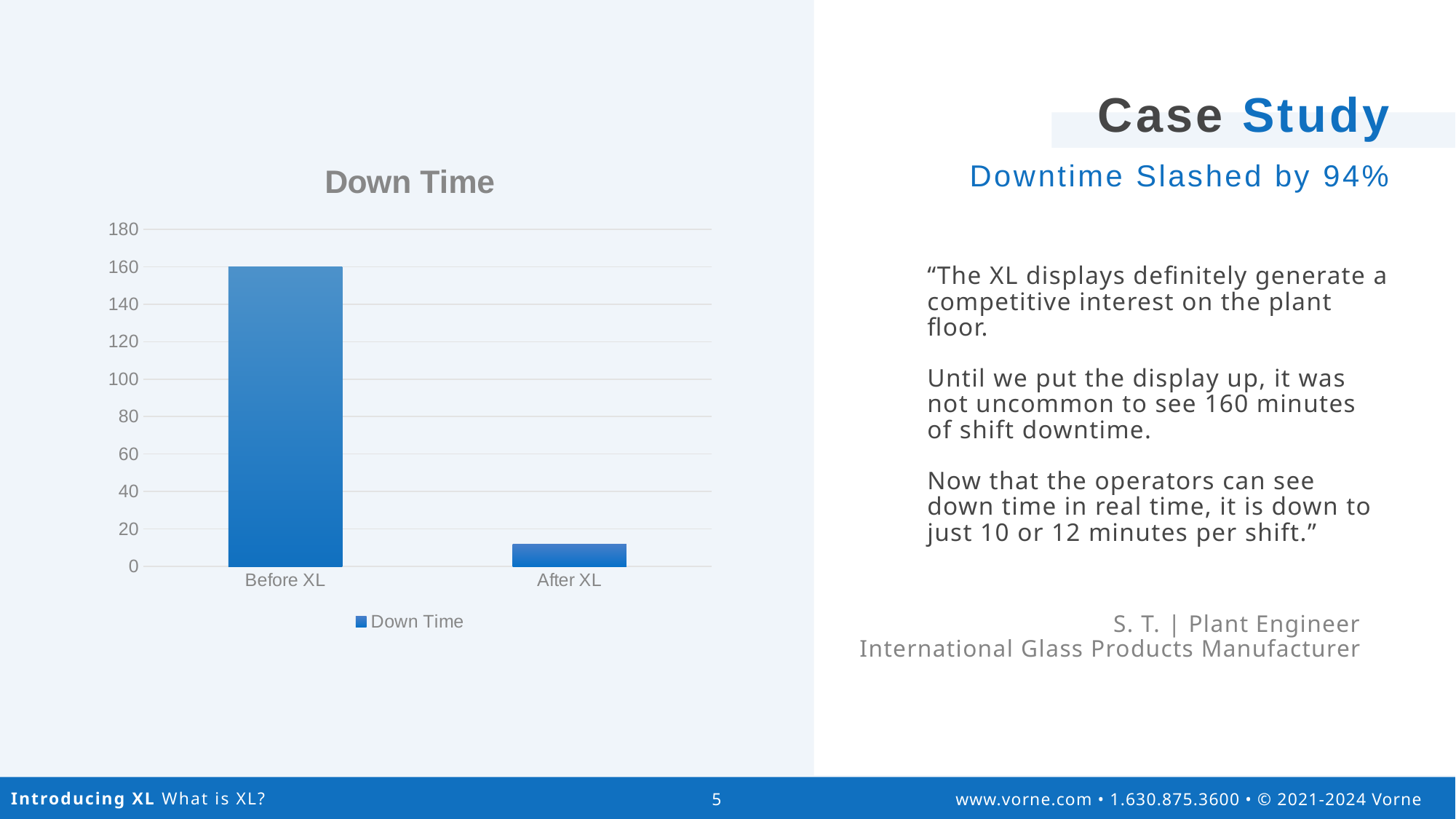
Do the values rise or fall from Before XL to After XL? fall How many categories are shown on the x axis of the chart? 2 What series name appears in the chart legend? Down Time Is the value for After XL greater or less than 20? less Which category has the lowest down time value? After XL Which category has the highest down time value? Before XL Which is larger, the value for Before XL or the value for After XL? Before XL What type of chart is shown on the slide? bar chart What is the title of the chart? Down Time What is the down time value for Before XL? 160 Is the value for Before XL greater or less than 140? greater How many series does the chart legend list? 1